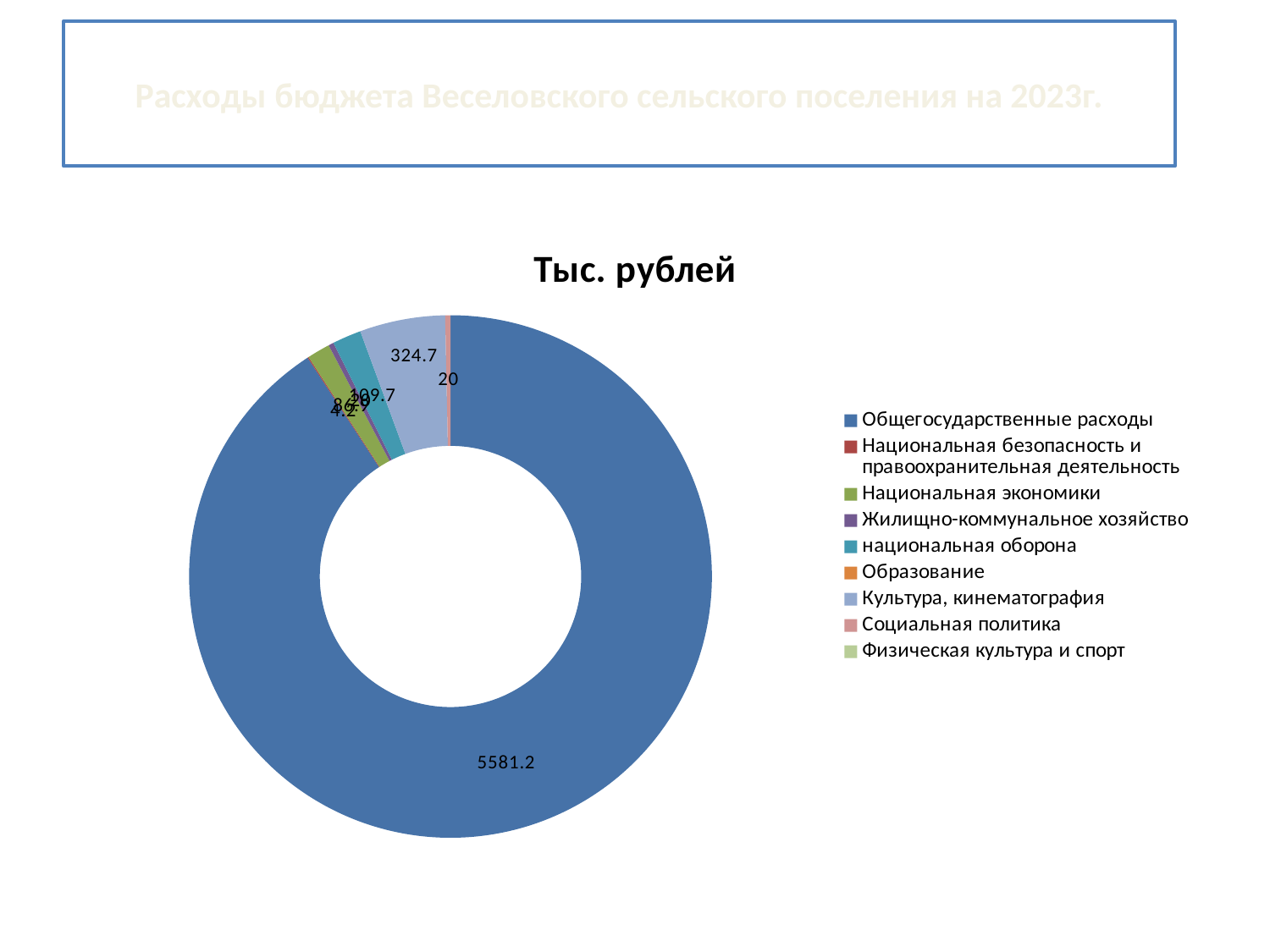
Which is larger: Культура, кинематография or национальная оборона? Культура, кинематография What is the value for Культура, кинематография? 324.7 What is the value for Социальная политика? 20 What colour is the slice for Общегосударственные расходы? Blue How many categories does the legend of the chart list? 9 What is the value for национальная оборона? 109.7 What kind of chart is shown on the slide? Doughnut chart What is the title of the chart? Тыс. рублей What is the difference between the values for Культура, кинематография and национальная оборона? 215 What is the value for Общегосударственные расходы? 5581.2 What is the difference between the values for Культура, кинематография and Социальная политика? 304.7 Which category has the largest slice in the chart? Общегосударственные расходы